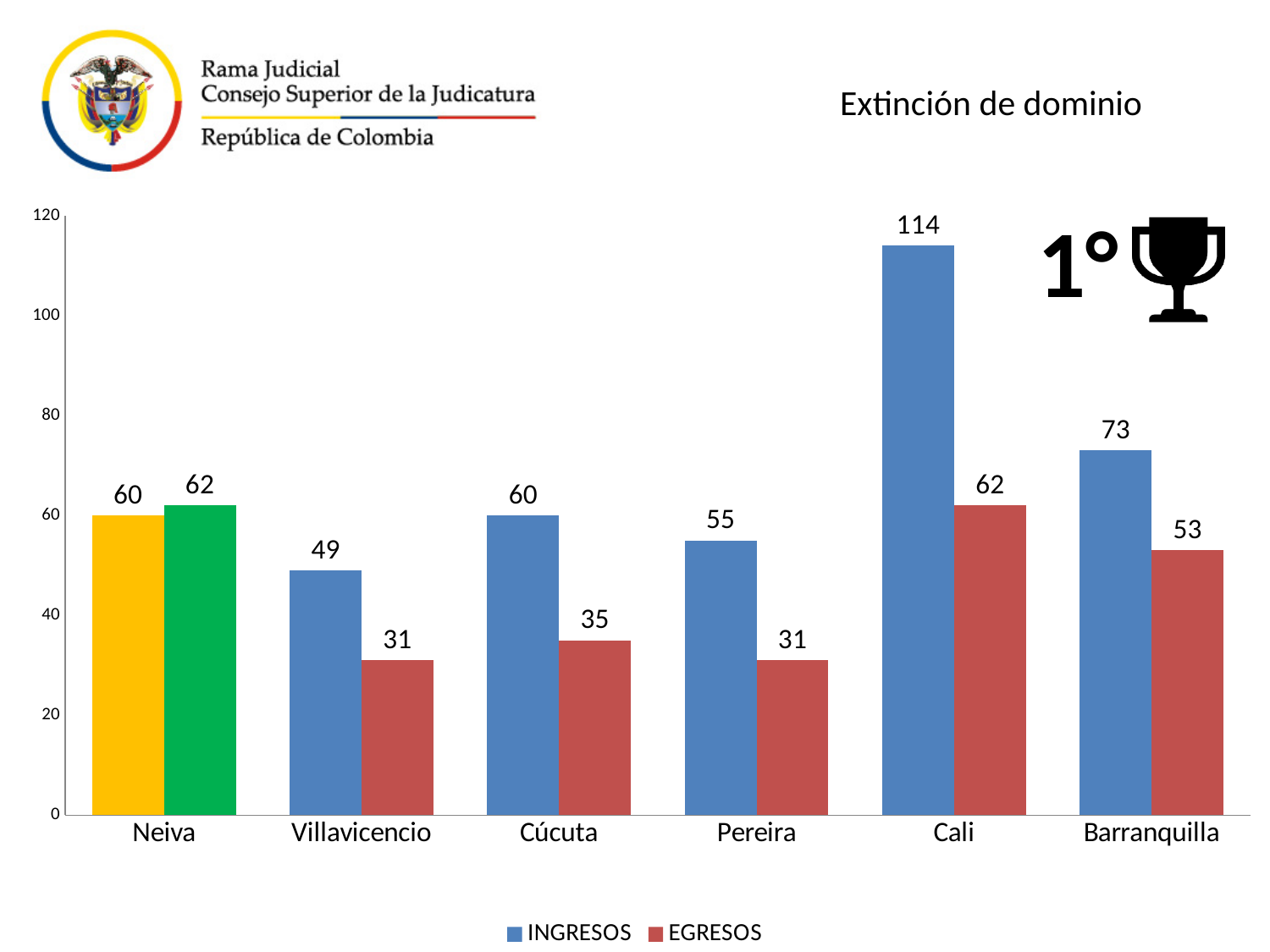
What is the EGRESOS value for Neiva? 62 What kind of chart is shown on the slide? bar chart Which city has the highest INGRESOS value? Cali What is the INGRESOS value for Cali? 114 Is the INGRESOS value for Cali greater or less than 100? greater How many series does the legend list? 2 What is the difference between the INGRESOS values for Barranquilla and Pereira? 18 What is the difference between INGRESOS and EGRESOS for Cali? 52 Which city has the lowest INGRESOS value? Villavicencio How many cities are shown on the x axis? 6 What is the EGRESOS value for Villavicencio? 31 Which is larger, the EGRESOS value for Barranquilla or the EGRESOS value for Cúcuta? Barranquilla